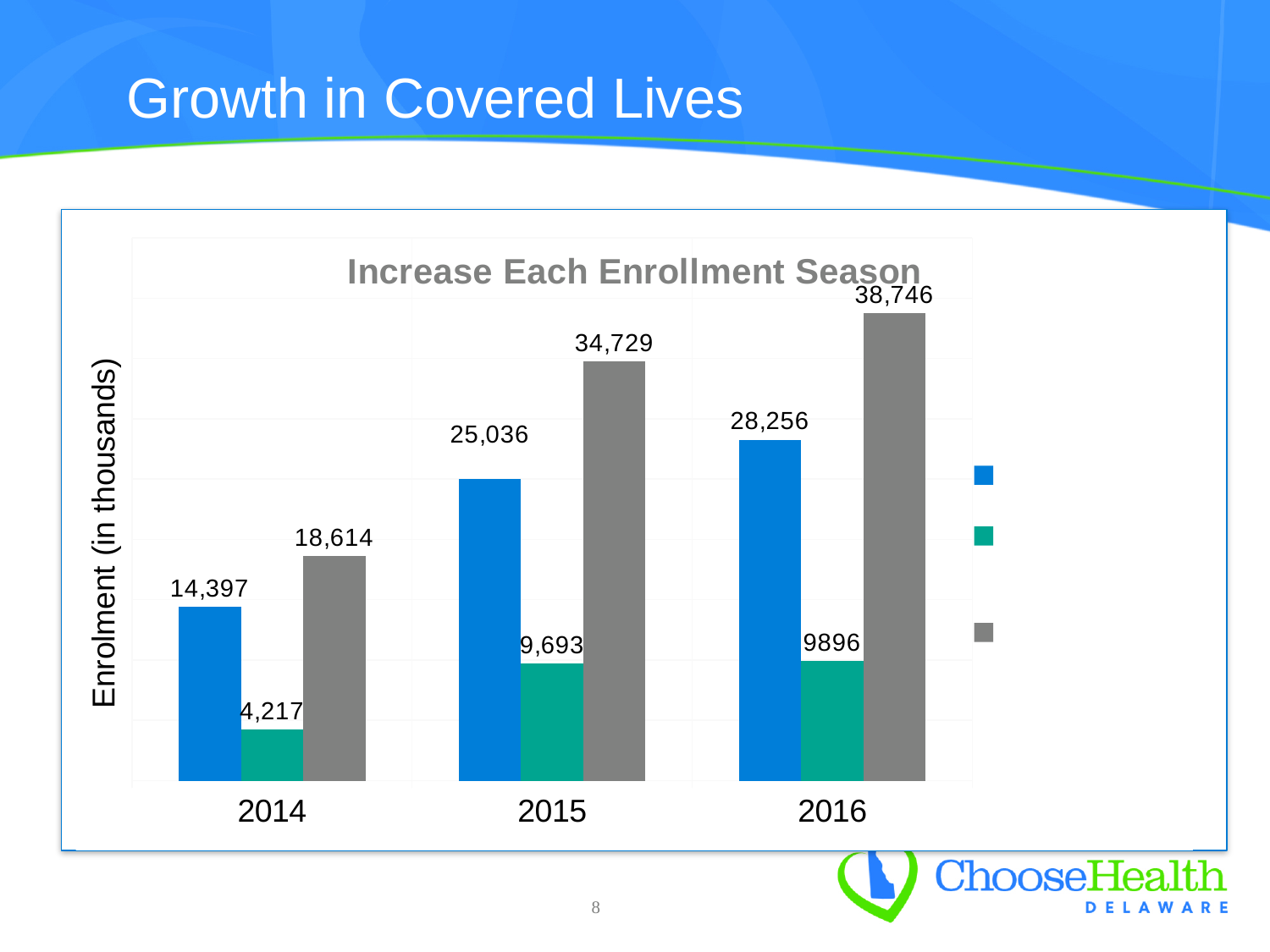
What is the label on the vertical axis of the chart? Enrolment (in thousands) What is the value of the gray bar for 2016? 38,746 What is the value of the teal bar for 2014? 4,217 What is the value of the blue bar for 2015? 25,036 Which year has the lowest value for the blue series? 2014 Do the values of the blue series rise or fall from 2014 to 2016? Rise What is the title of the chart? Increase Each Enrollment Season How many years are shown on the x axis of the chart? 3 Which year has the highest value for the gray series? 2016 What type of chart is shown on the slide? Bar chart How many series does the legend of the chart list? 3 What is the difference between the gray bar values for 2015 and 2014? 16,115